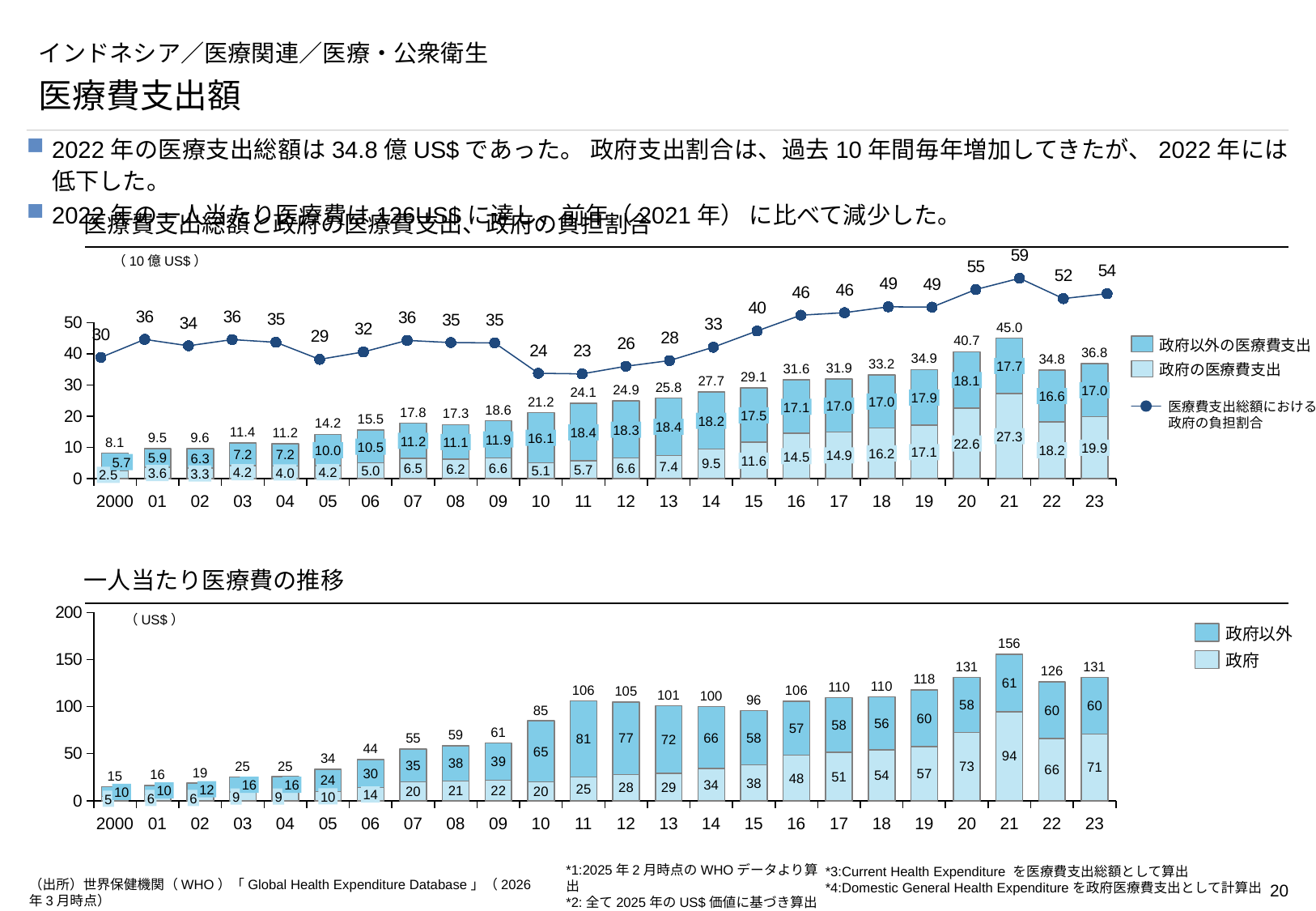
In the bottom chart, did the government (政府) per-capita expenditure rise or fall from 2016 to 2021? Rise In the top chart, what was the total health expenditure in 2021 (10億US$)? 45.0 In the top chart, by how much did the total health expenditure fall from 2021 to 2022? 10.2 In the bottom chart (一人当たり医療費の推移), what was the per-capita health expenditure in 2021 (US$)? 156 In the bottom chart, what was the government (政府) per-capita health expenditure in 2023? 71 How many years are plotted on the x axis of the bottom chart? 24 How many series does the legend of the top chart list? 3 What kind of chart is the bottom chart (一人当たり医療費の推移)? Stacked bar chart In the top chart, what was the government health expenditure (政府の医療費支出) in 2022? 18.2 In the top chart, in which year was the government's share of total health expenditure (line) lowest? 2011 In the bottom chart, which year had the higher total per-capita health expenditure, 2022 or 2023? 2023 In the top chart, in which year did the government's share of total health expenditure (line) reach its highest value? 2021